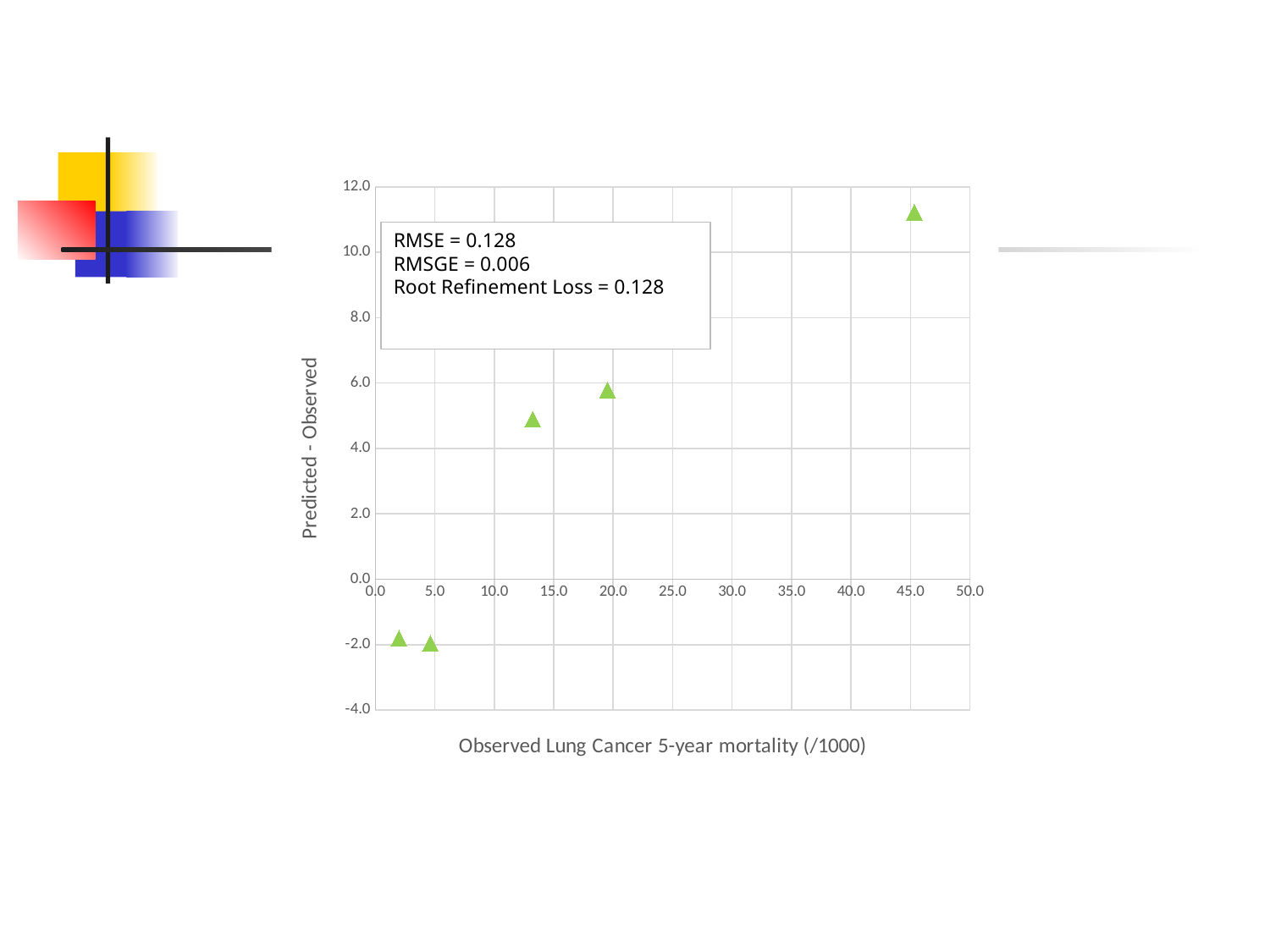
Is the y value of the point near x = 13 greater or less than 4.0? greater Which point has the highest y value: the one near x = 45 or the one near x = 19.5? the one near x = 45 Is the y value of the rightmost point (near x = 45) greater or less than 10.0? greater Is the y value of the point near x = 19.5 greater or less than 6.0? less What kind of chart is shown on the slide? scatter chart What RMSE value is reported in the text box on the chart? 0.128 Do the plotted values generally rise or fall as the observed mortality increases along the x axis? rise What is the title of the x axis? Observed Lung Cancer 5-year mortality (/1000) What RMSGE value is reported in the text box on the chart? 0.006 What is the title of the y axis? Predicted - Observed How many data points are plotted on the chart? 5